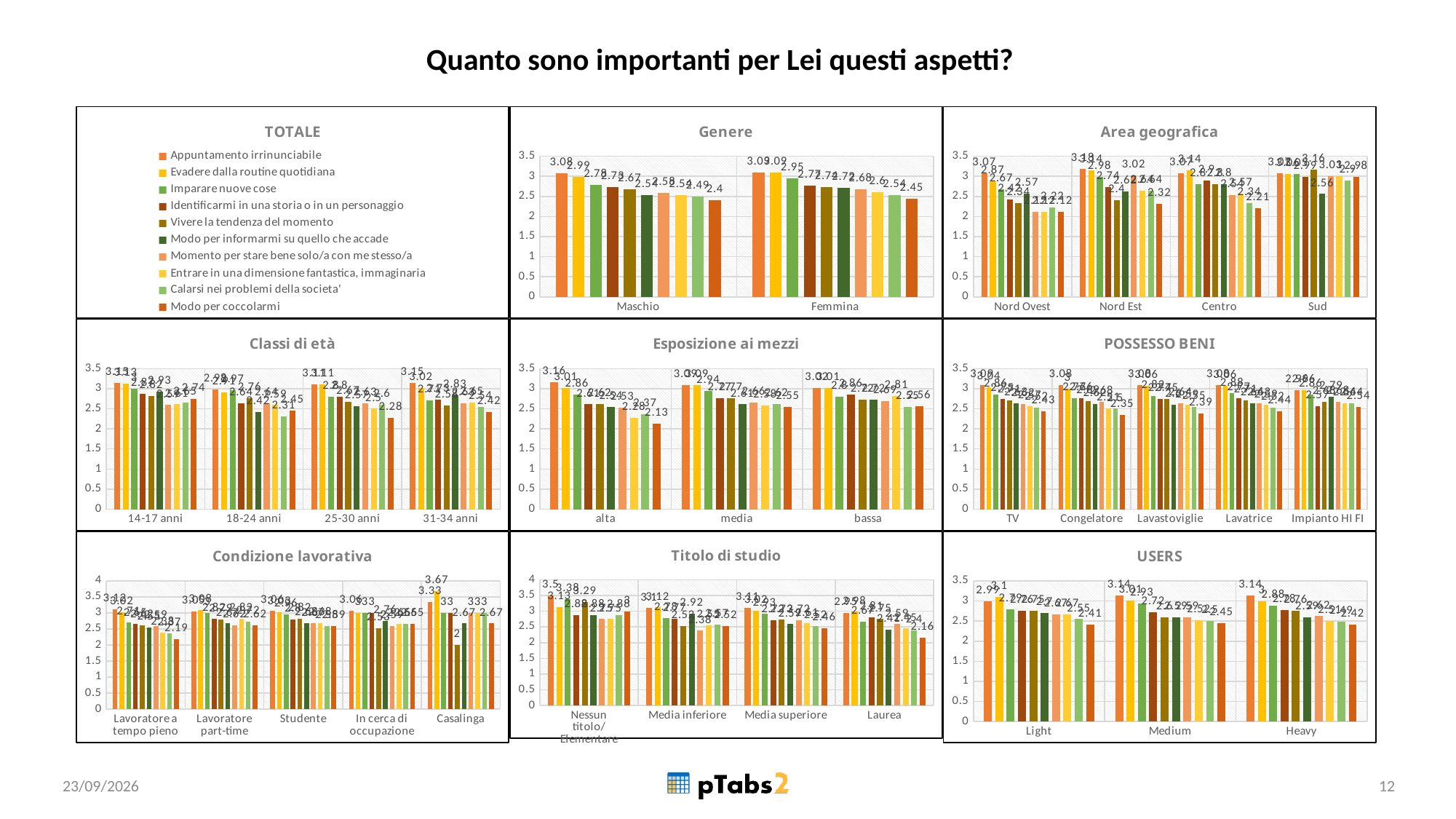
In the Genere chart, which is larger for Imparare nuove cose: Maschio or Femmina? Femmina In the Titolo di studio chart, what is the value for Appuntamento irrinunciabile for Nessun titolo/Elementare? 3.5 In the Esposizione ai mezzi chart, is the value for Modo per coccolarmi for alta greater or less than 2.5? less How many series does the TOTALE legend list? 10 In the Genere chart, what is the value for Modo per coccolarmi for Femmina? 2.45 How many categories are shown on the x axis of the USERS chart? 3 In the Condizione lavorativa chart, what is the lowest value shown for Casalinga? 2 In the Condizione lavorativa chart, what is the highest value shown for Casalinga? 3.67 How many categories are shown on the x axis of the Area geografica chart? 4 In the USERS chart, what is the value for Appuntamento irrinunciabile for Heavy? 3.14 What kind of chart is the Area geografica chart? bar chart In the Genere chart, what is the value for Appuntamento irrinunciabile for Maschio? 3.08